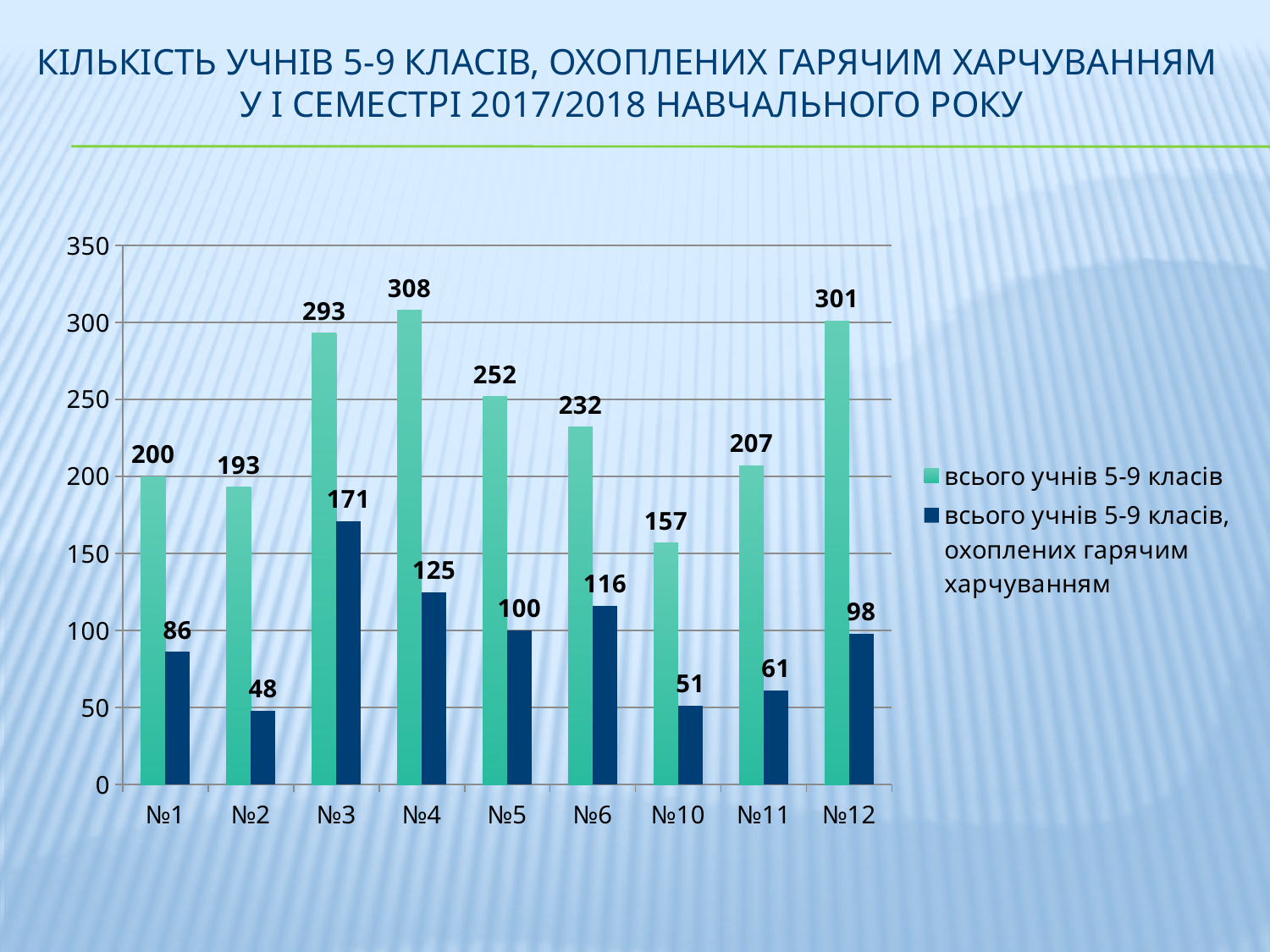
What is the value of 'всього учнів 5-9 класів' for №4? 308 What is the difference between 'всього учнів 5-9 класів' and 'всього учнів 5-9 класів, охоплених гарячим харчуванням' for №3? 122 How many series does the legend list? 2 What kind of chart is shown on the slide? bar chart What colour are the bars for 'всього учнів 5-9 класів, охоплених гарячим харчуванням'? dark blue How many categories are shown on the x axis? 9 Which category has the highest value for 'всього учнів 5-9 класів'? №4 Which is larger: 'всього учнів 5-9 класів' for №5 or for №6? №5 What is the value of 'всього учнів 5-9 класів, охоплених гарячим харчуванням' for №2? 48 Is the value of 'всього учнів 5-9 класів' for №10 greater or less than 150? greater Which category has the lowest value for 'всього учнів 5-9 класів'? №10 Which category has the lowest value for 'всього учнів 5-9 класів, охоплених гарячим харчуванням'? №2